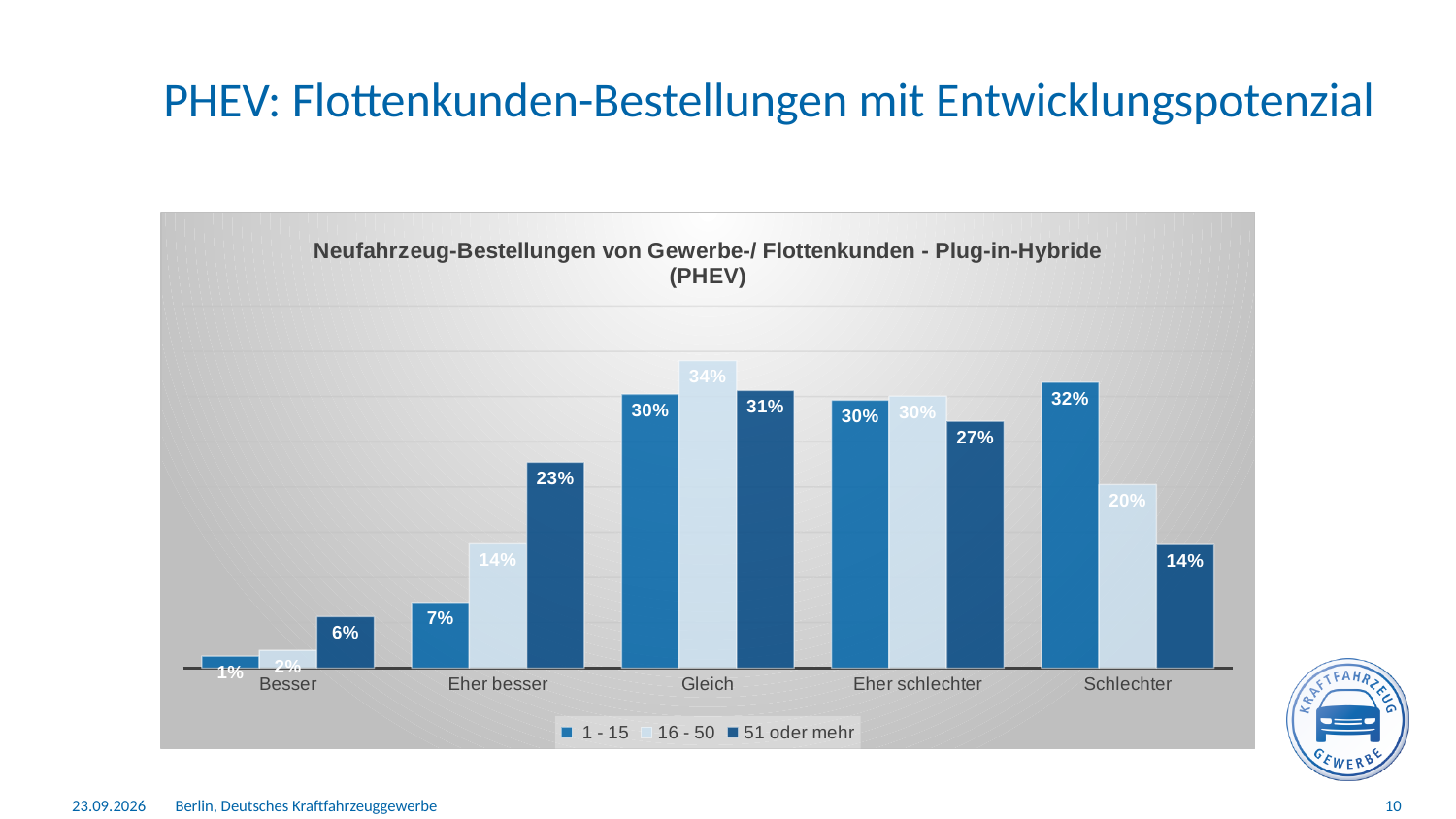
What is the value for '51 oder mehr' in the 'Eher besser' category? 23% What is the difference between the '16 - 50' and '51 oder mehr' values in the 'Eher schlechter' category? 3% What is the value for '16 - 50' in the 'Gleich' category? 34% How many categories are shown on the x axis? 5 What is the value for '1 - 15' in the 'Schlechter' category? 32% How many series does the legend list? 3 In which category does the '51 oder mehr' series reach its highest value? Gleich Which is larger in the 'Eher besser' category: the '16 - 50' value or the '51 oder mehr' value? 51 oder mehr In which category does the '1 - 15' series have its lowest value? Besser What type of chart is shown on the slide? Bar chart What is the difference between the '1 - 15' and '51 oder mehr' values in the 'Schlechter' category? 18% What is the title of the chart? Neufahrzeug-Bestellungen von Gewerbe-/ Flottenkunden - Plug-in-Hybride (PHEV)